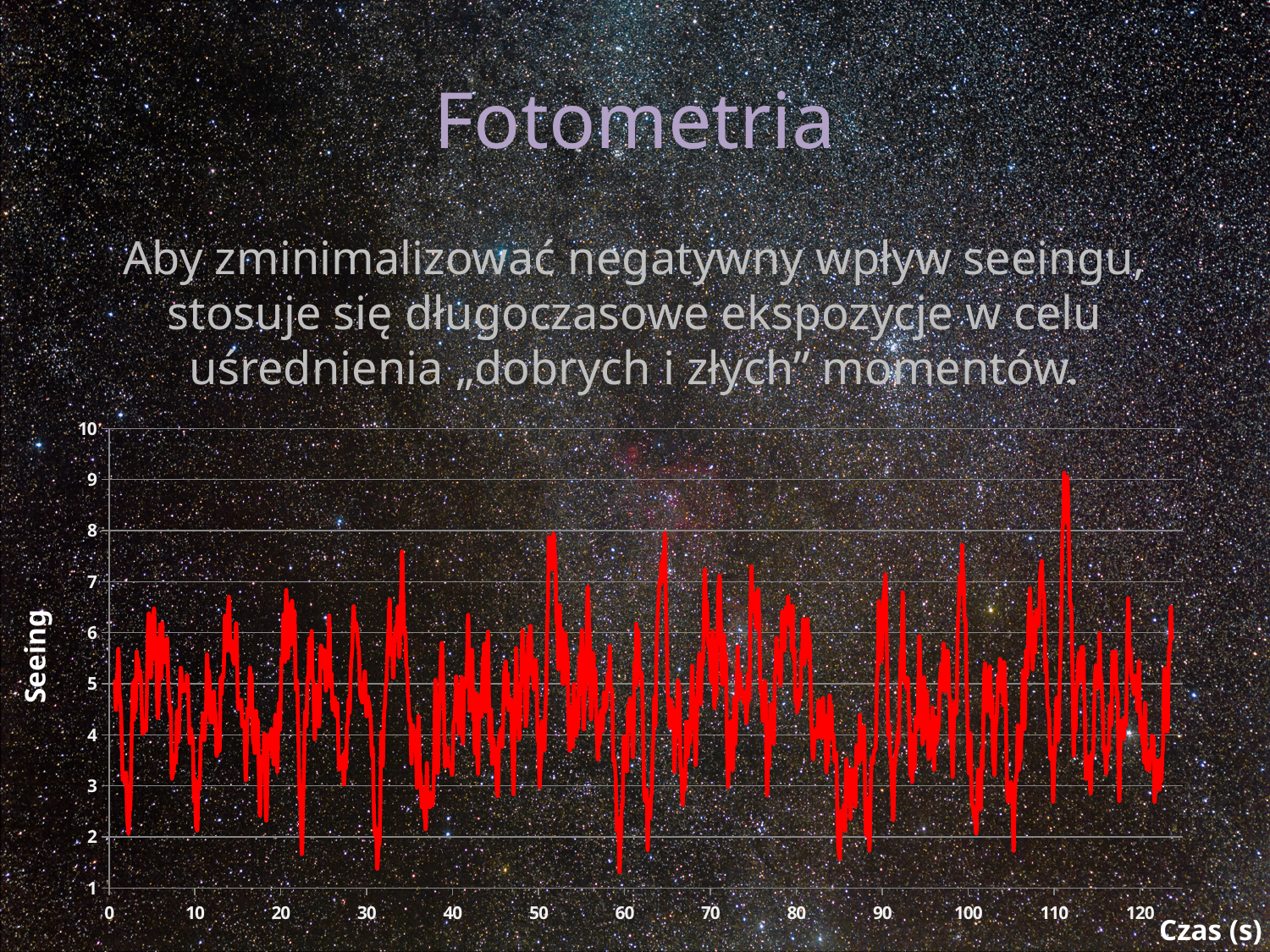
Is the highest peak of the seeing line greater or less than 8? greater What is the highest tick value shown on the vertical axis? 10 What is the highest tick value shown on the horizontal axis? 120 What is the label of the vertical axis of the chart? Seeing Does the seeing line show a clear overall upward or downward trend along the time axis? no clear trend What is the lowest tick value shown on the vertical axis? 1 Is the lowest dip of the seeing line greater or less than 2? less What is the label of the horizontal axis of the chart? Czas (s) Is the dip of the seeing line near 60 s greater or less than 2? less What kind of chart is shown on the slide? line chart